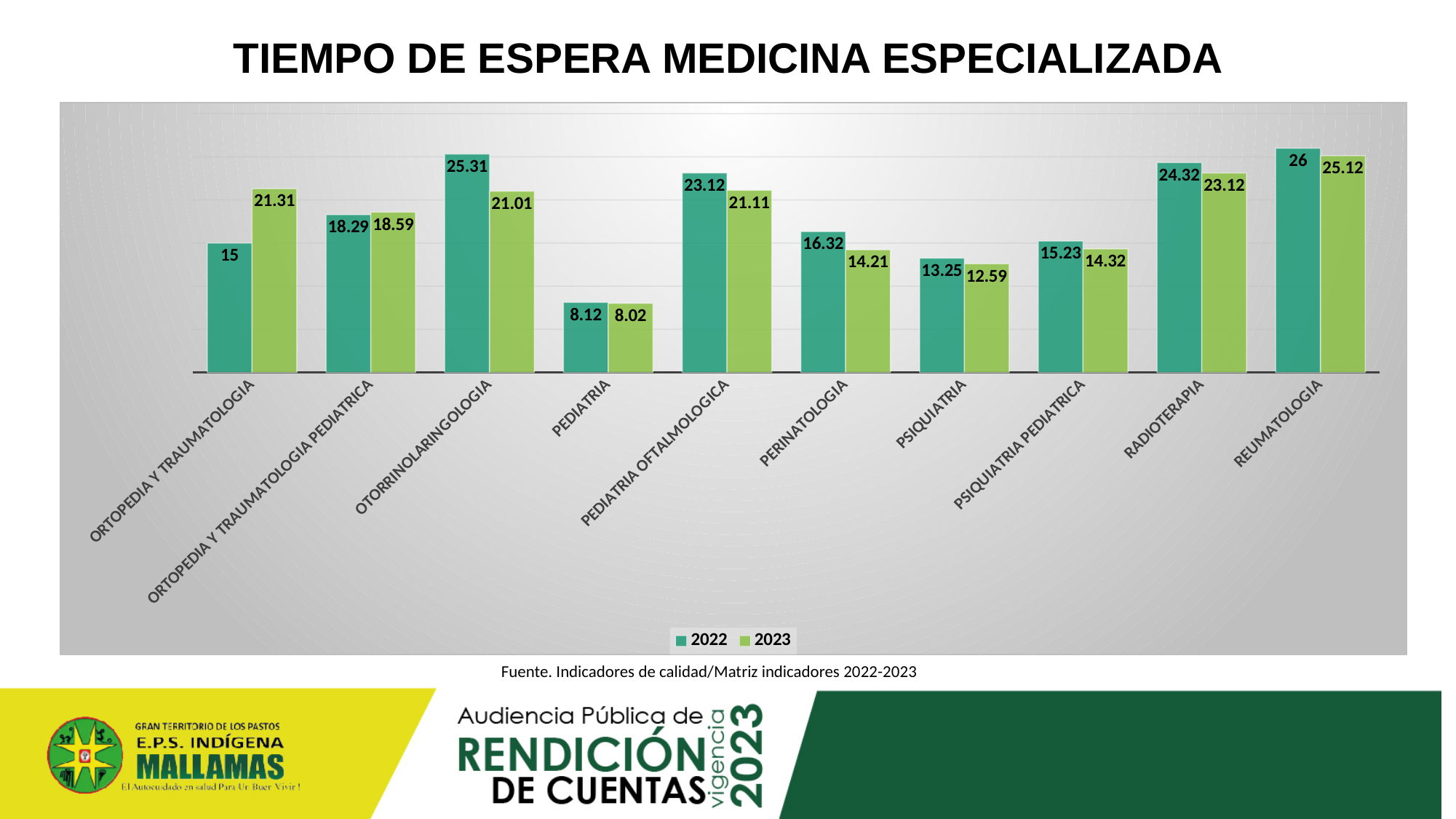
What kind of chart is shown on the slide? Bar chart Which category has the lowest 2023 value? PEDIATRIA For PEDIATRIA OFTALMOLOGICA, which year has the larger value, 2022 or 2023? 2022 Which category has the highest 2022 value? REUMATOLOGIA How many series does the legend list? 2 What is the 2023 value for ORTOPEDIA Y TRAUMATOLOGIA? 21.31 What is the 2022 value for OTORRINOLARINGOLOGIA? 25.31 What is the 2023 value for RADIOTERAPIA? 23.12 What is the difference between the 2022 and 2023 values for OTORRINOLARINGOLOGIA? 4.30 How many categories are shown on the x axis? 10 What is the title of the chart? TIEMPO DE ESPERA MEDICINA ESPECIALIZADA What is the difference between the 2023 and 2022 values for ORTOPEDIA Y TRAUMATOLOGIA? 6.31